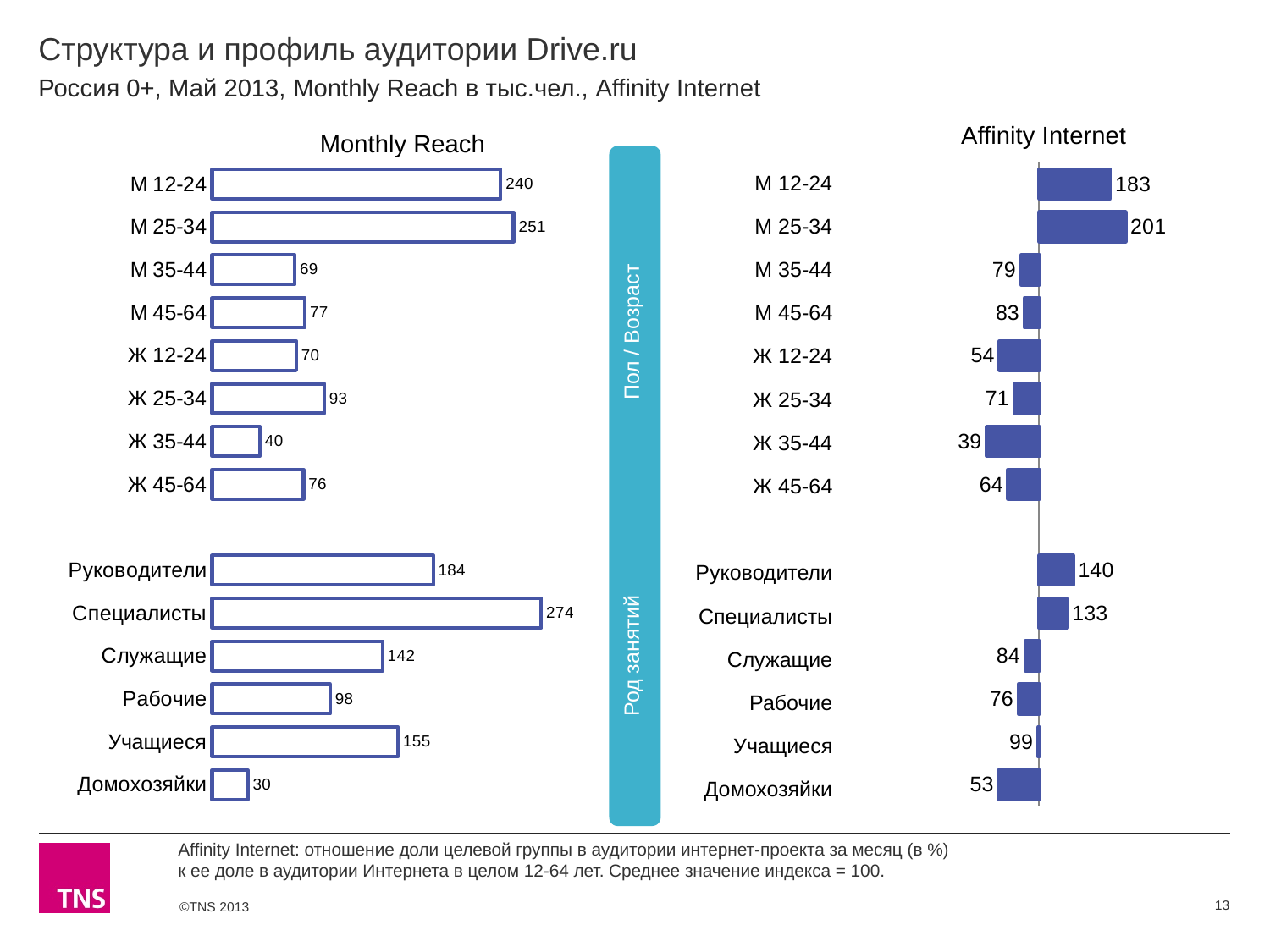
In the Affinity Internet chart, which category has the lowest value? Ж 35-44 In the Monthly Reach chart, how many categories are plotted? 14 In the Affinity Internet chart, what is the difference between the values for Руководители and Специалисты? 7 In the Affinity Internet chart, which is larger: the value for М 12-24 or the value for М 25-34? М 25-34 In the Monthly Reach chart, which is larger: the value for Ж 25-34 or the value for Ж 45-64? Ж 25-34 What kind of chart is the Affinity Internet chart? Bar chart In the Affinity Internet chart, what is the value for Ж 35-44? 39 What is the title of the chart on the left side of the slide? Monthly Reach In the Monthly Reach chart, which category has the highest value? Специалисты In the Monthly Reach chart, what is the value for М 25-34? 251 In the Monthly Reach chart, what is the difference between the values for Руководители and Служащие? 42 In the Monthly Reach chart, what is the value for Домохозяйки? 30